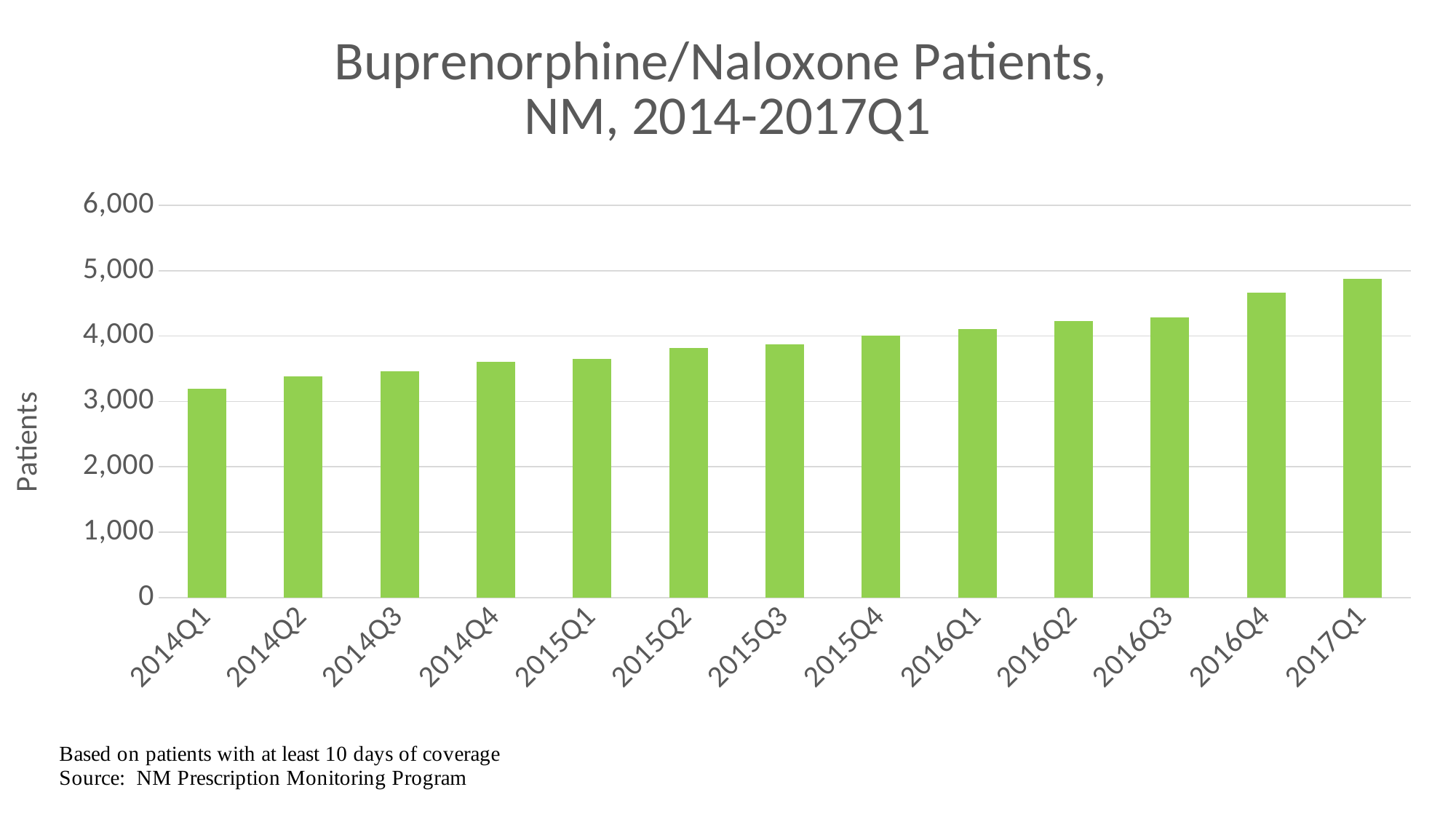
Is the value for 2017Q1 greater or less than 5,000? less Which quarter has the lowest number of patients? 2014Q1 What kind of chart is shown on the slide? bar chart Which quarter has the highest number of patients? 2017Q1 How many quarters are plotted on the chart? 13 Do the patient counts rise or fall from 2014Q1 to 2017Q1? rise Is the value for 2016Q4 greater or less than 4,000? greater Is the value for 2014Q1 greater or less than 3,000? greater What is the label on the vertical axis? Patients What is the title of the chart? Buprenorphine/Naloxone Patients, NM, 2014-2017Q1 Which is larger, the value for 2016Q4 or the value for 2014Q4? 2016Q4